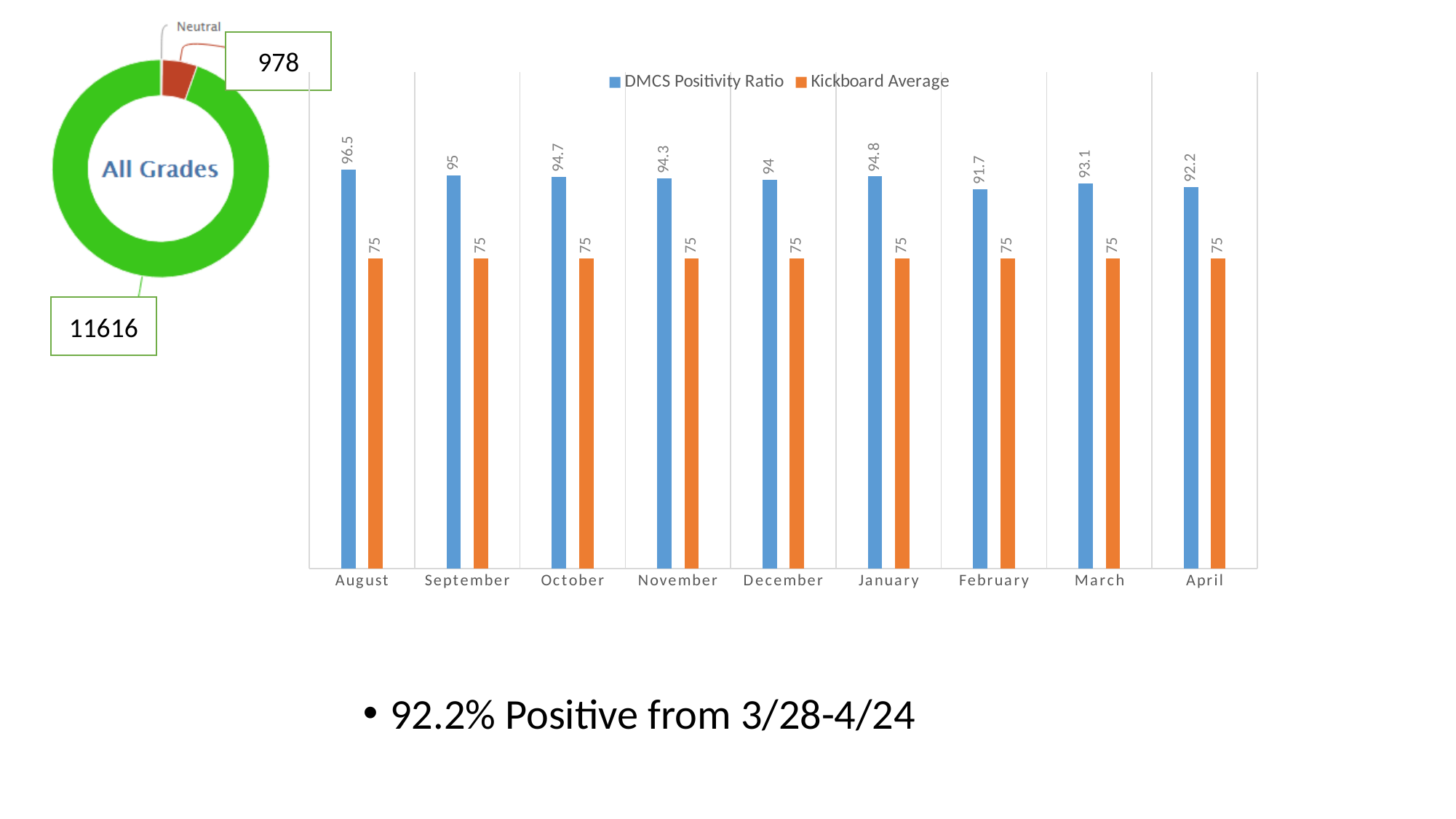
In the bar chart, what is the difference between the DMCS Positivity Ratio and the Kickboard Average in August? 21.5 In the bar chart, which month has the lowest DMCS Positivity Ratio? February In the bar chart, what is the DMCS Positivity Ratio for August? 96.5 In the bar chart, what is the DMCS Positivity Ratio for February? 91.7 In the All Grades chart on the left, what value is shown for the Neutral slice? 978 In the bar chart, what is the Kickboard Average value for December? 75 How many months are shown on the x axis of the bar chart? 9 What kind of chart is the chart on the right of the slide? Bar chart How many series does the legend of the bar chart list? 2 In the All Grades chart on the left, what value is shown for the large green slice? 11616 In the bar chart, is the DMCS Positivity Ratio higher in March or in April? March In the bar chart, which month has the highest DMCS Positivity Ratio? August